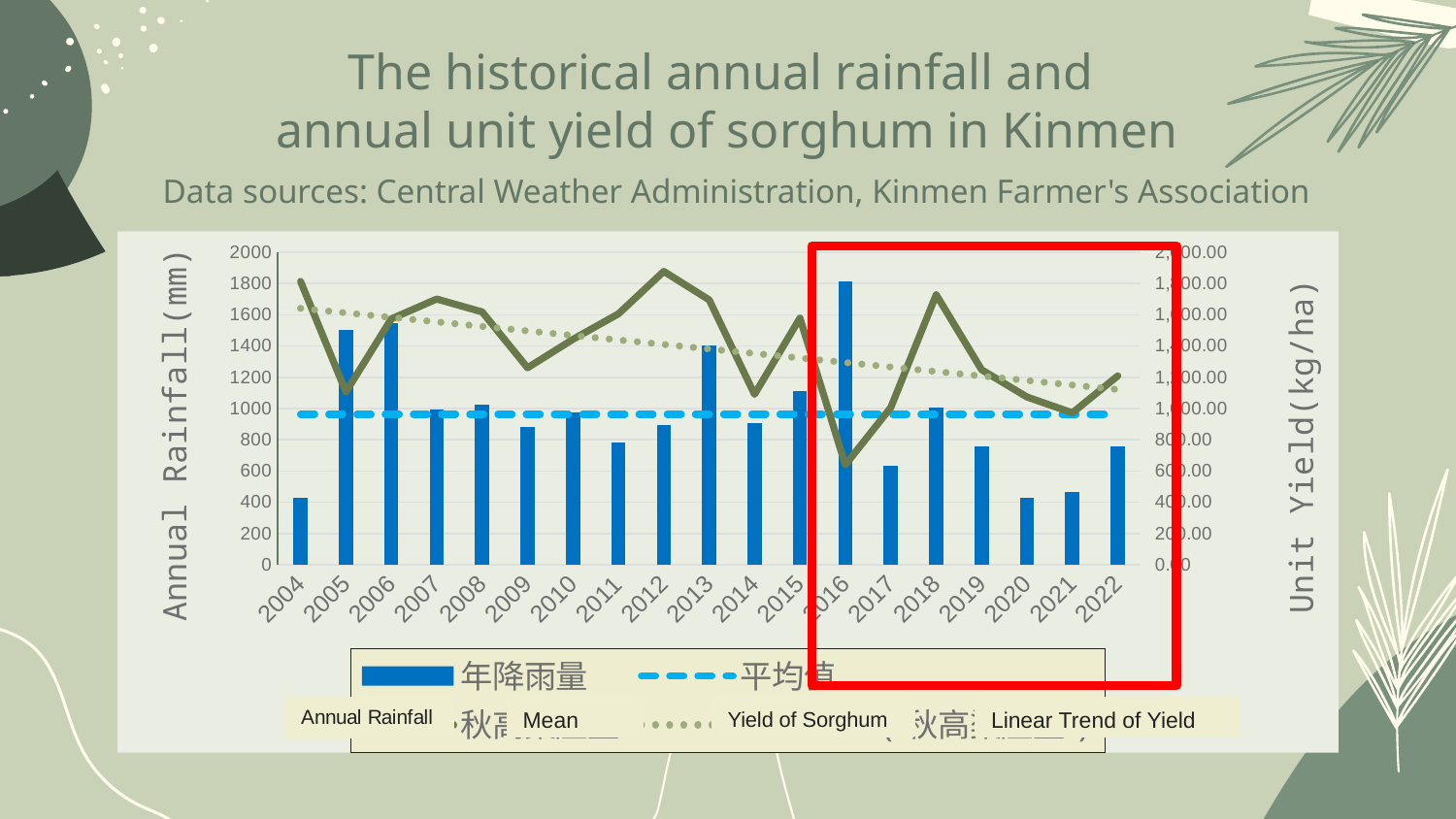
Is the annual rainfall for 2005 greater or less than 1400? greater Is the annual rainfall for 2016 greater or less than 1600? greater Is the Yield of Sorghum for 2012 greater or less than 1,600.00? greater What is the title of the left vertical axis? Annual Rainfall(mm) In which year is the Yield of Sorghum line at its lowest point? 2016 How many years are shown on the x axis? 19 Does the Linear Trend of Yield line rise or fall from 2004 to 2022? fall Which year has the highest annual rainfall bar? 2016 Which year has the larger annual rainfall bar, 2013 or 2014? 2013 How many series does the legend list? 4